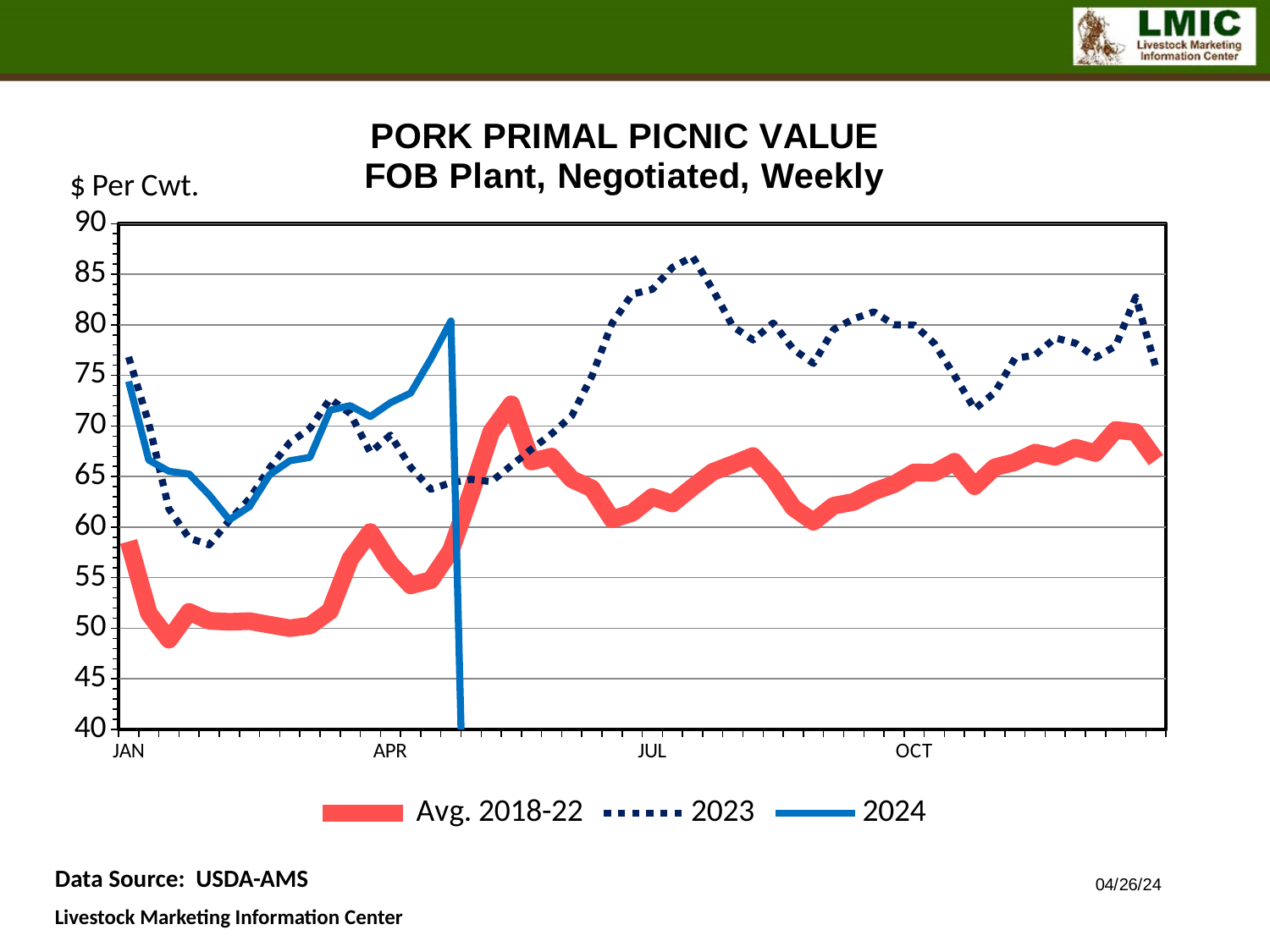
Which series reaches the highest value anywhere on the chart? 2023 Is the lowest value of the Avg. 2018-22 series greater or less than 50? less Does the 2024 series rise or fall from the start of January to early February? fall What is the title of the chart? PORK PRIMAL PICNIC VALUE FOB Plant, Negotiated, Weekly What unit is shown on the vertical axis label? $ Per Cwt. Is the peak value of the 2023 series greater or less than 80? greater What kind of chart is shown on the slide? line chart Around July, which is larger: the 2023 series or the Avg. 2018-22 series? 2023 How many series does the legend list? 3 Is the value of the 2024 series at the start of January greater or less than 70? greater At the start of January, which is larger: the 2024 series or the Avg. 2018-22 series? 2024